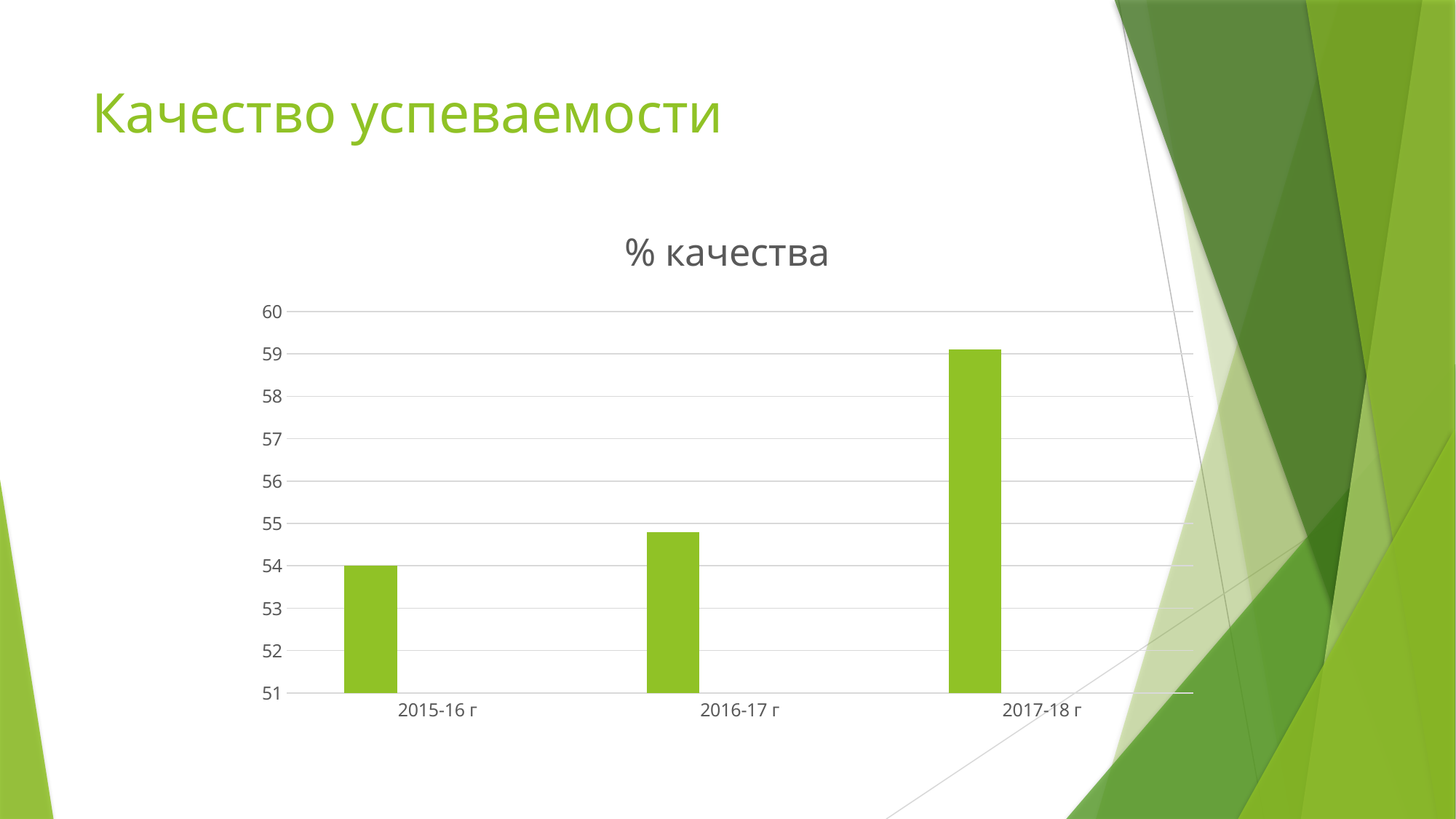
Is the value for 2016-17 г greater or less than 54? greater Which year has the lowest value in the chart? 2015-16 г How many categories (years) are shown on the x axis of the chart? 3 What is the title of the chart? % качества What is the value for 2015-16 г? 54 Which is larger, the value for 2016-17 г or the value for 2015-16 г? 2016-17 г Is the value for 2017-18 г greater or less than 58? greater Which year has the highest value in the chart? 2017-18 г Is the value for 2016-17 г greater or less than 55? less What type of chart is shown on the slide? bar chart What colour are the bars in the chart? green Do the values rise or fall from 2015-16 г to 2017-18 г? rise